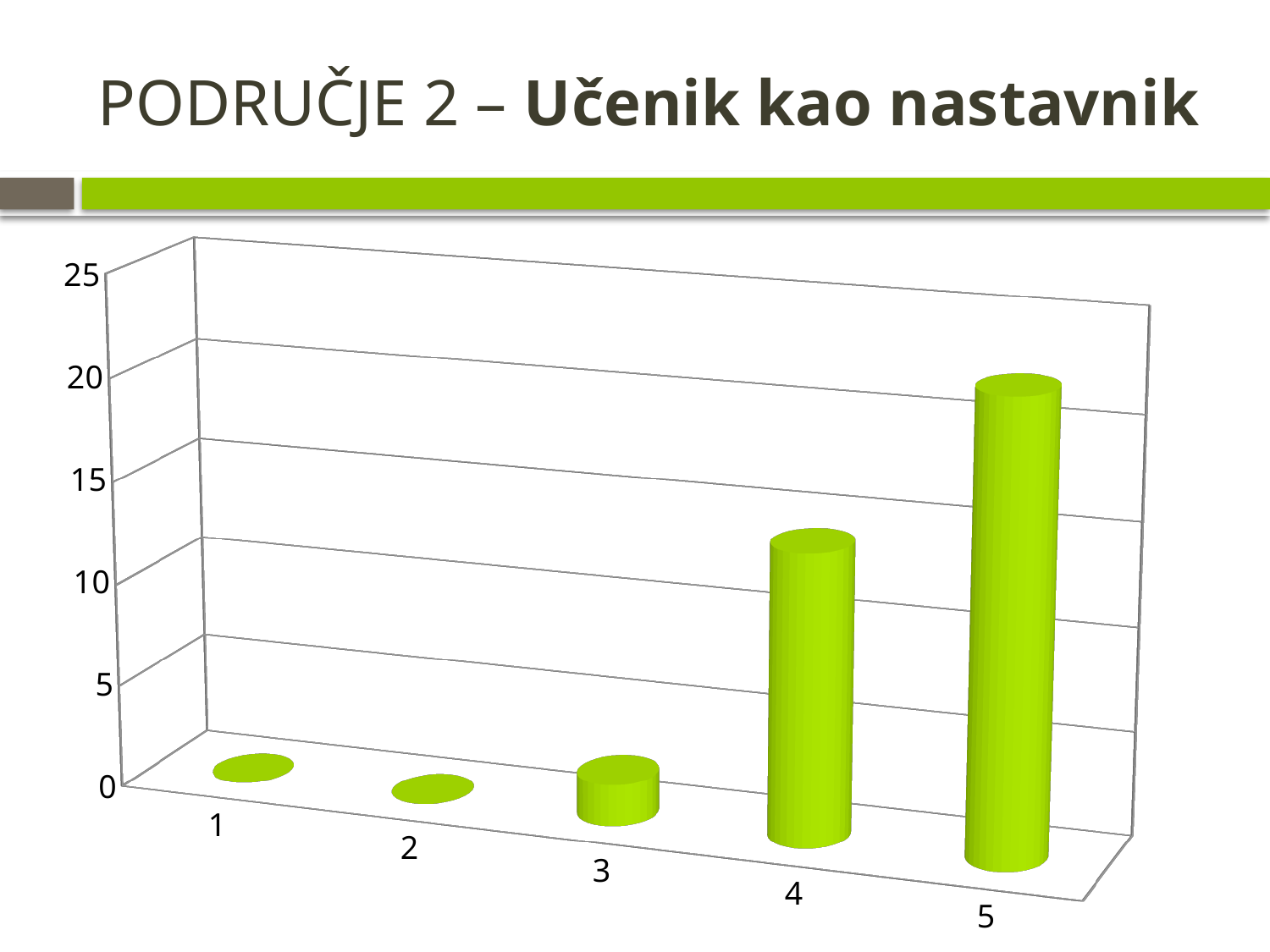
Is the value for category 3 greater or less than 5? less Do the values rise or fall from category 1 to category 5? rise Is the value for category 4 greater or less than 15? less How many categories are shown on the x axis of the chart? 5 What kind of chart is shown on the slide? bar chart Is the value for category 5 greater or less than 15? greater What is the title of the slide containing the chart? PODRUČJE 2 – Učenik kao nastavnik Which is larger, the value for category 3 or the value for category 4? 4 What is the highest value shown on the vertical axis of the chart? 25 Which category has the highest value in the chart? 5 Which is larger, the value for category 4 or the value for category 5? 5